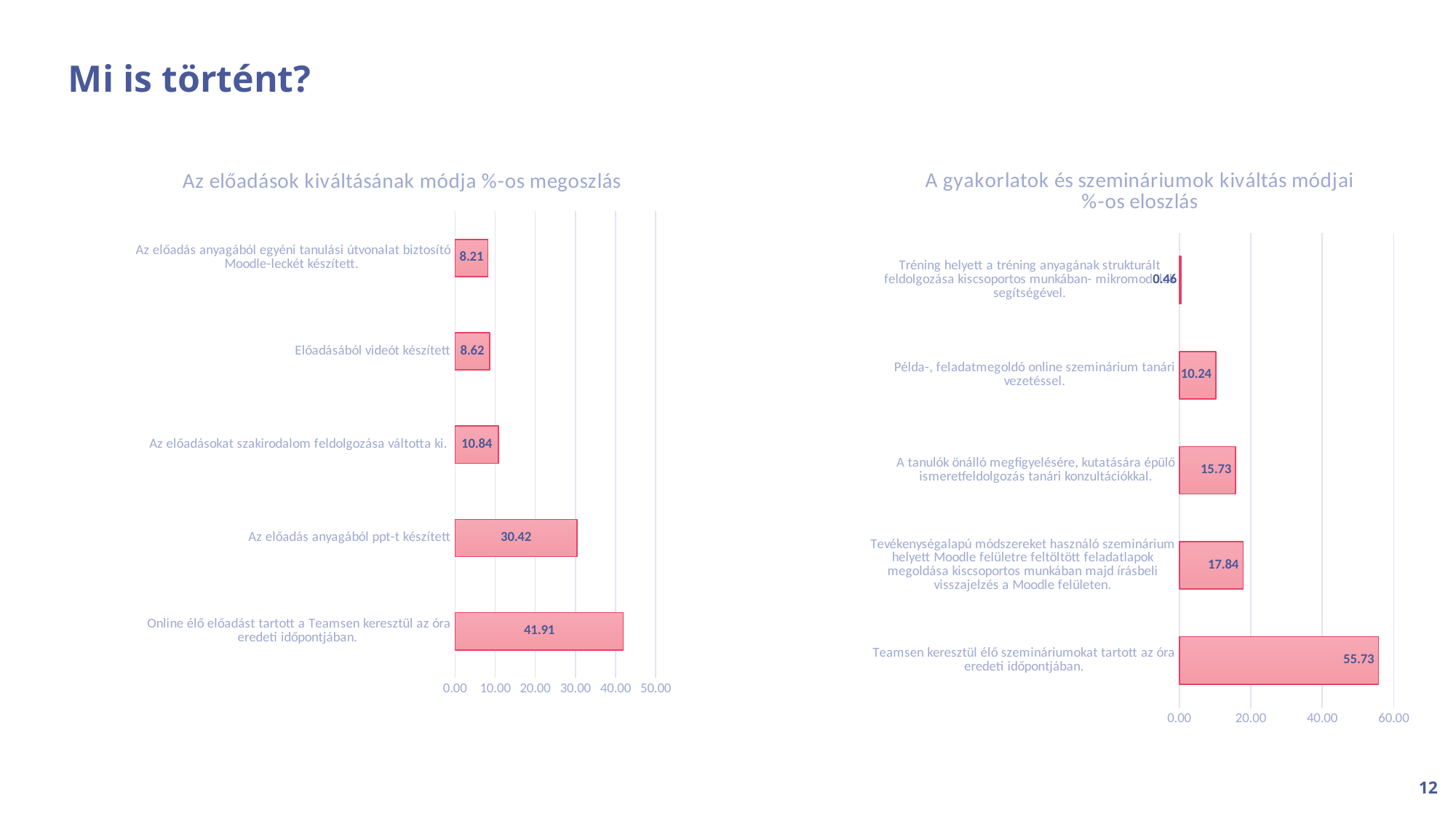
In the chart titled "Az előadások kiváltásának módja %-os megoszlás", what is the difference between the values for "Online élő előadást tartott a Teamsen keresztül az óra eredeti időpontjában." and "Az előadás anyagából ppt-t készített"? 11.49 In the chart titled "Az előadások kiváltásának módja %-os megoszlás", how many categories are shown? 5 In the chart titled "Az előadások kiváltásának módja %-os megoszlás", which category has the highest value? Online élő előadást tartott a Teamsen keresztül az óra eredeti időpontjában. In the chart titled "Az előadások kiváltásának módja %-os megoszlás", is the value for "Az előadásokat szakirodalom feldolgozása váltotta ki." greater or less than 10.00? greater In the chart titled "A gyakorlatok és szemináriumok kiváltás módjai %-os eloszlás", which is larger: the value for "A tanulók önálló megfigyelésére, kutatására épülő ismeretfeldolgozás tanári konzultációkkal." or the value for "Példa-, feladatmegoldó online szeminárium tanári vezetéssel."? A tanulók önálló megfigyelésére, kutatására épülő ismeretfeldolgozás tanári konzultációkkal. In the chart titled "A gyakorlatok és szemináriumok kiváltás módjai %-os eloszlás", what is the value for "Példa-, feladatmegoldó online szeminárium tanári vezetéssel."? 10.24 In the chart titled "A gyakorlatok és szemináriumok kiváltás módjai %-os eloszlás", what is the value for "Teamsen keresztül élő szemináriumokat tartott az óra eredeti időpontjában."? 55.73 What type of chart is the chart on the right side of the slide? bar chart In the chart titled "A gyakorlatok és szemináriumok kiváltás módjai %-os eloszlás", which category has the lowest value? Tréning helyett a tréning anyagának strukturált feldolgozása kiscsoportos munkában- mikromodulok segítségével. In the chart titled "Az előadások kiváltásának módja %-os megoszlás", what is the value for "Az előadás anyagából ppt-t készített"? 30.42 In the chart titled "Az előadások kiváltásának módja %-os megoszlás", what is the value for "Előadásából videót készített"? 8.62